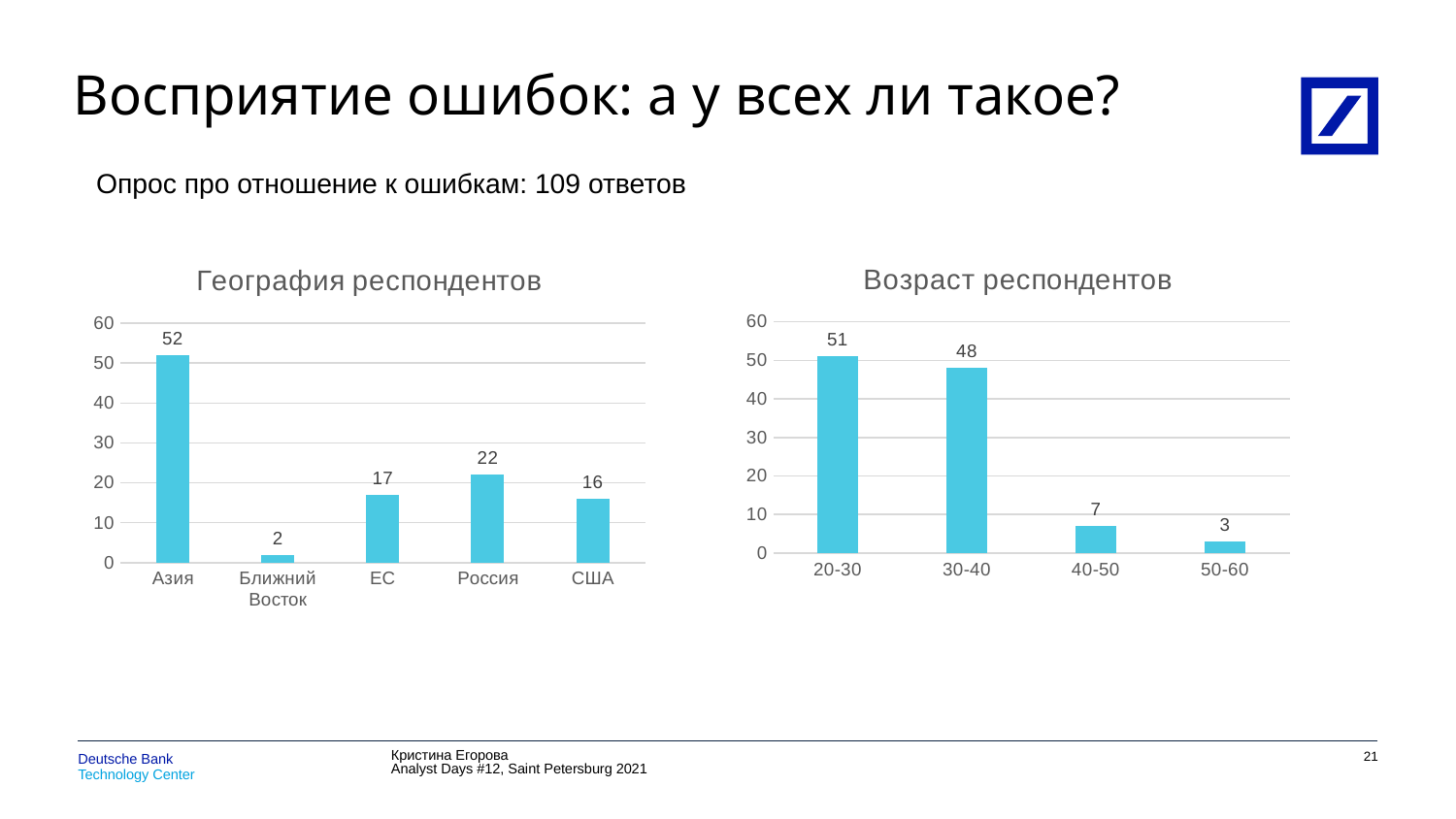
What is the title of the chart on the left side of the slide? География респондентов In the 'Возраст респондентов' chart, which age group has the highest value? 20-30 In the 'География респондентов' chart, which category has the lowest value? Ближний Восток In the 'География респондентов' chart, what is the difference between the values for Азия and США? 36 In the 'Возраст респондентов' chart, what is the value for 40-50? 7 In the 'География респондентов' chart, what is the value for Россия? 22 What kind of chart is the 'Возраст респондентов' chart? bar chart In the 'Возраст респондентов' chart, what is the difference between the values for 20-30 and 30-40? 3 How many categories are shown in the 'География респондентов' chart? 5 In the 'География респондентов' chart, which is larger: the value for ЕС or the value for Россия? Россия In the 'Возраст респондентов' chart, do the values rise or fall from left to right along the x axis? fall In the 'География респондентов' chart, what is the value for Азия? 52